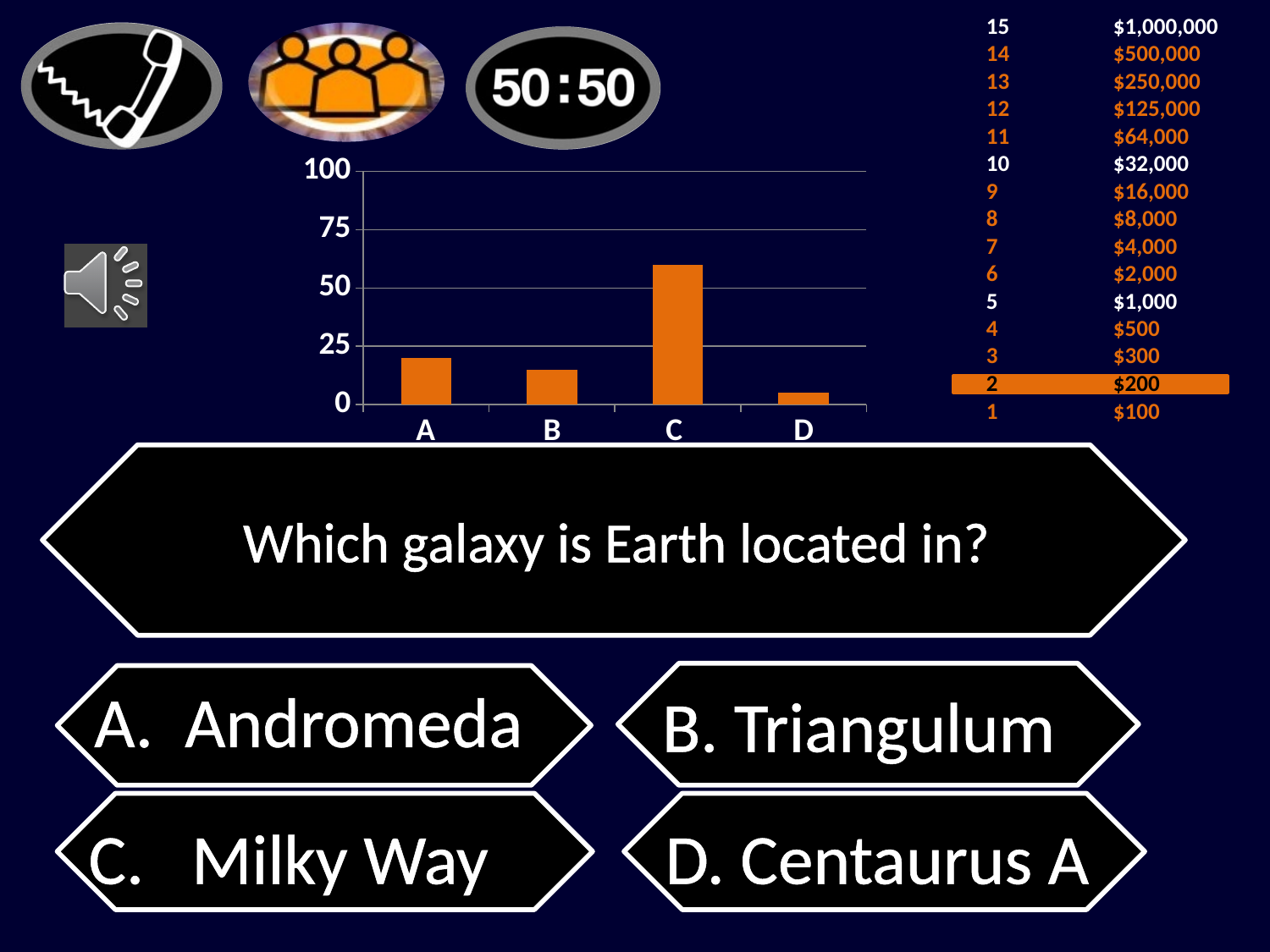
Is the value for C greater or less than 50? greater Is the value for C greater or less than 75? less Which category has the lowest bar in the chart? D What kind of chart is shown on the slide? bar chart What is the highest value shown on the y axis of the chart? 100 Is the value for A greater or less than 25? less Which category has the highest bar in the chart? C Which is larger, the value for B or the value for D? B How many categories are shown on the x axis of the bar chart? 4 Which is larger, the value for A or the value for B? A Which is larger, the value for C or the value for A? C